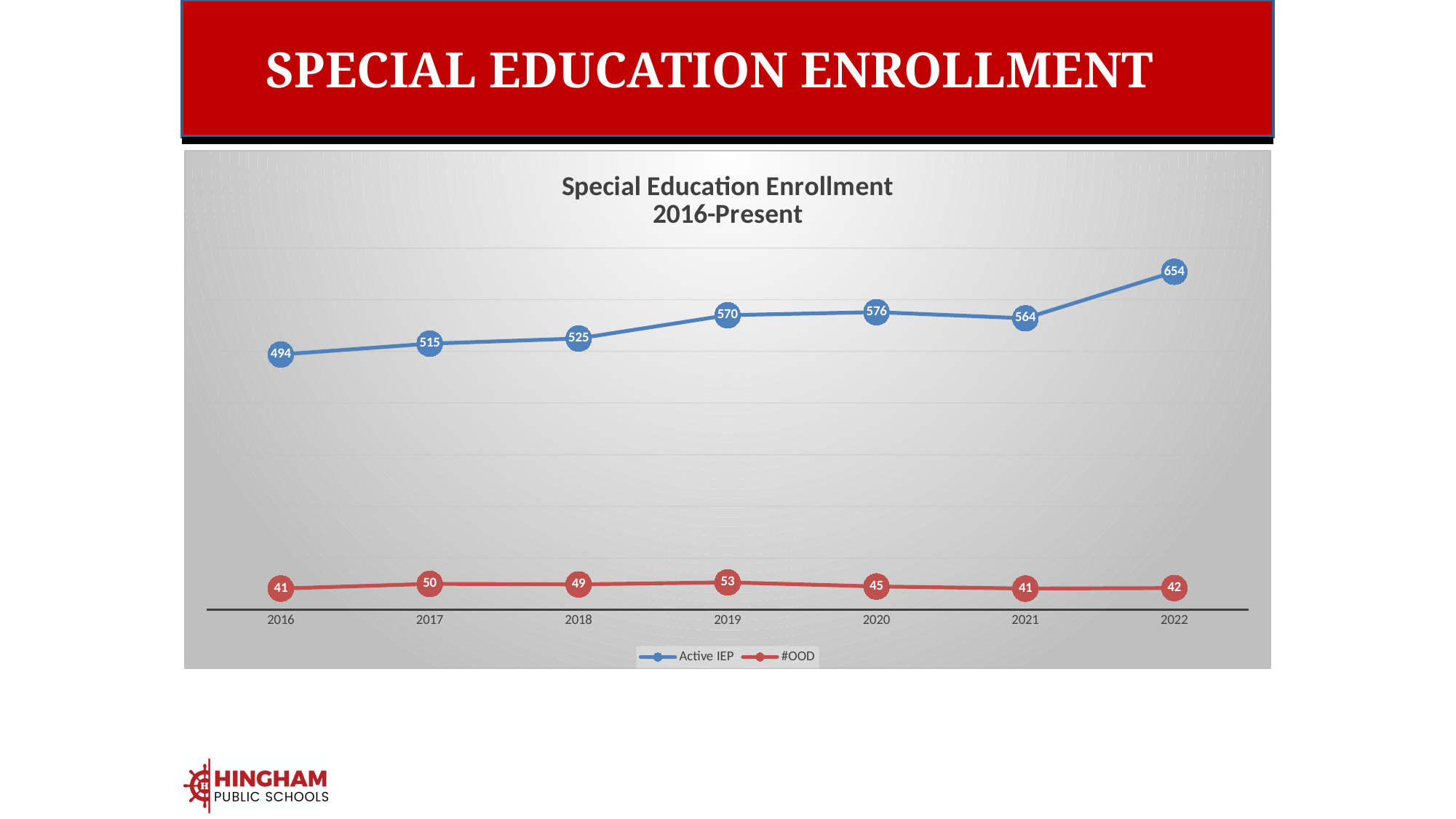
In which year is the Active IEP value lowest? 2016 What is the difference between the Active IEP values for 2022 and 2021? 90 In which year is the Active IEP value highest? 2022 What is the title of the chart? Special Education Enrollment 2016-Present What is the #OOD value for 2019? 53 In which year is the #OOD value highest? 2019 How many years are shown on the x axis? 7 Which is larger, the #OOD value for 2017 or for 2020? 2017 What is the Active IEP value for 2022? 654 How many series does the legend list? 2 What is the Active IEP value for 2016? 494 What kind of chart is shown? Line chart